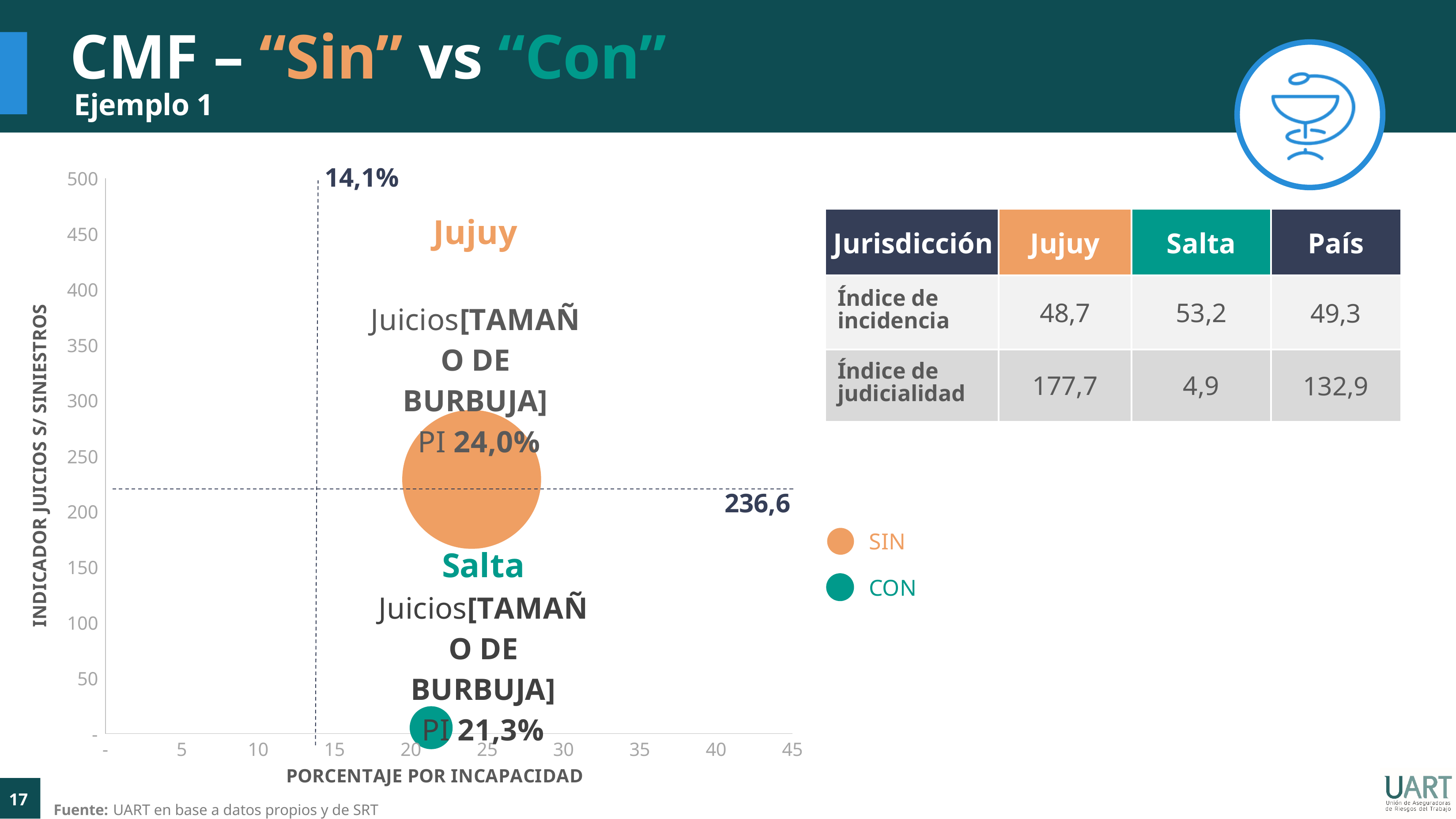
What value is labelled on the horizontal dashed reference line of the chart? 236,6 What is the difference between the PI values printed for Jujuy and Salta? 2,7 percentage points Which bubble sits higher on the 'Indicador juicios s/ siniestros' axis, Jujuy or Salta? Jujuy Is the Jujuy bubble's value on the vertical axis greater or less than 100? greater How many bubbles are plotted on the chart? 2 How many series does the legend of the bubble chart list? 2 What is the PI value printed for the Salta bubble? 21,3% What is the PI value printed for the Jujuy bubble? 24,0% What kind of chart is shown on the left of the slide? bubble chart What are the two entries in the chart's legend? SIN and CON Is the Salta bubble's value on the vertical axis greater or less than 50? less What value is labelled on the vertical dashed reference line of the chart? 14,1%